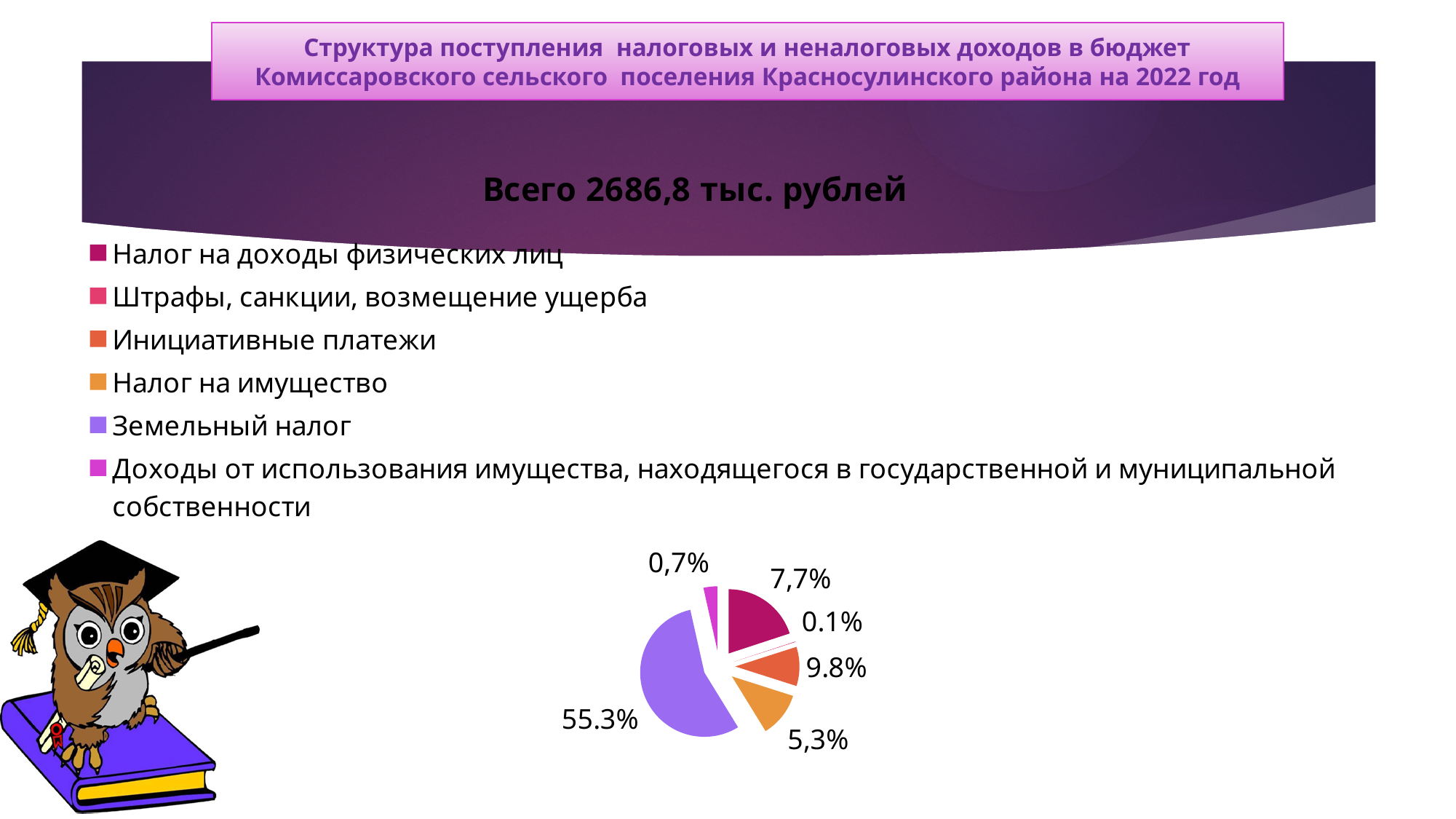
What share of the pie does Инициативные платежи have? 9.8% What share of the pie does Доходы от использования имущества, находящегося в государственной и муниципальной собственности have? 0,7% How many categories does the legend of the pie chart list? 6 Which category has the largest slice of the pie? Земельный налог Which category has the smallest slice of the pie? Штрафы, санкции, возмещение ущерба What share of the pie does Налог на имущество have? 5,3% What share of the pie does Налог на доходы физических лиц have? 7,7% What share of the pie does Штрафы, санкции, возмещение ущерба have? 0.1% What share of the pie does Земельный налог have? 55.3% What kind of chart is shown on the slide? Pie chart What total amount is stated above the chart? Всего 2686,8 тыс. рублей